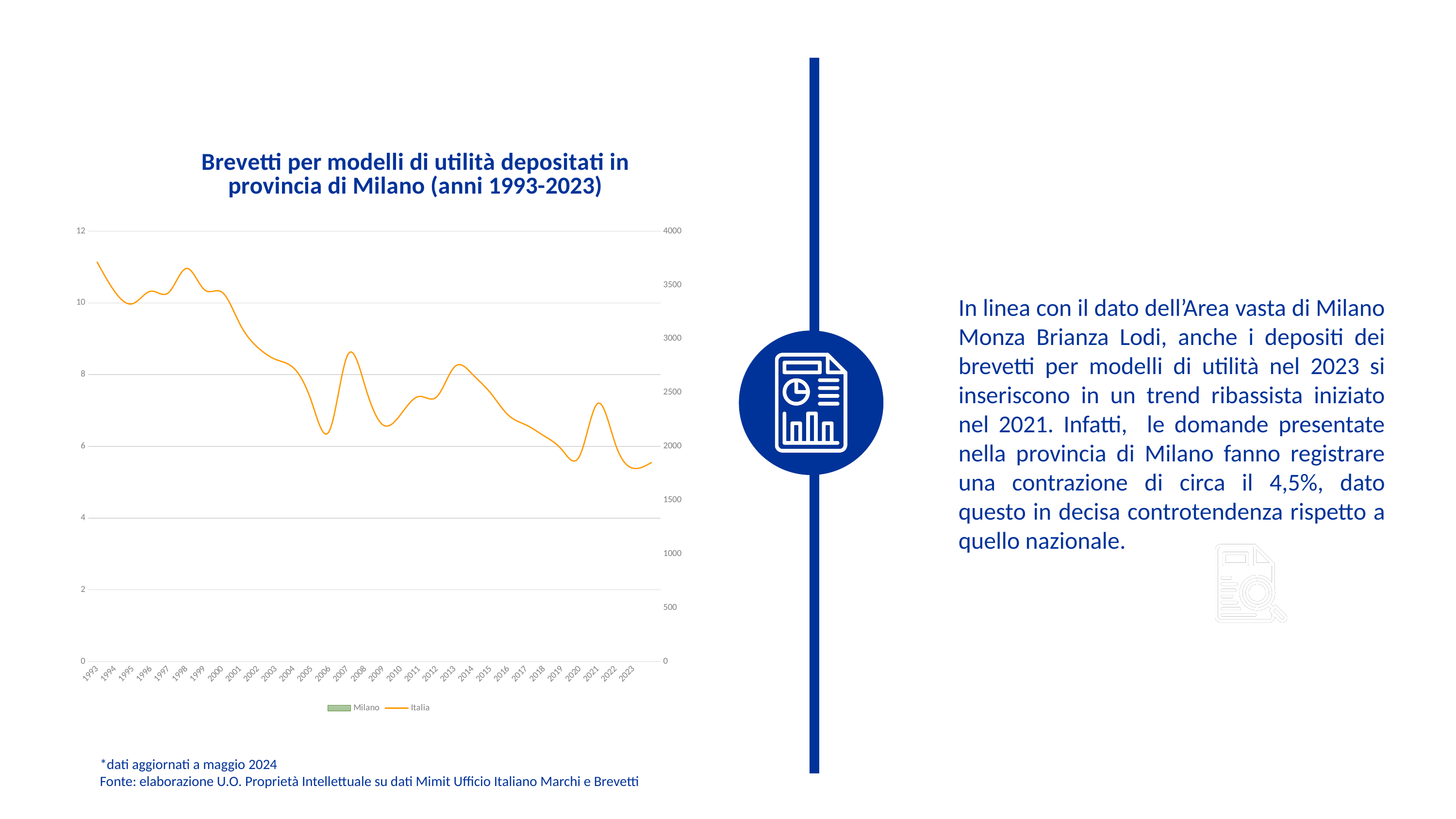
Which series is drawn as an orange line? Italia In which year does the Italia line reach its highest value? 1993 How many years are shown on the x axis of the chart? 31 What is the title of the chart? Brevetti per modelli di utilità depositati in provincia di Milano (anni 1993-2023) Is the Italia value higher in 1993 or in 2023? 1993 What type of chart is shown on the slide? line chart Is the Italia value higher in 2013 or in 2016? 2013 Is the Italia value higher in 2006 or in 2007? 2007 How many series does the chart legend list? 2 Overall, does the Italia line rise or fall from 1993 to 2023? fall Does the Italia line rise or fall between 2021 and 2022? fall